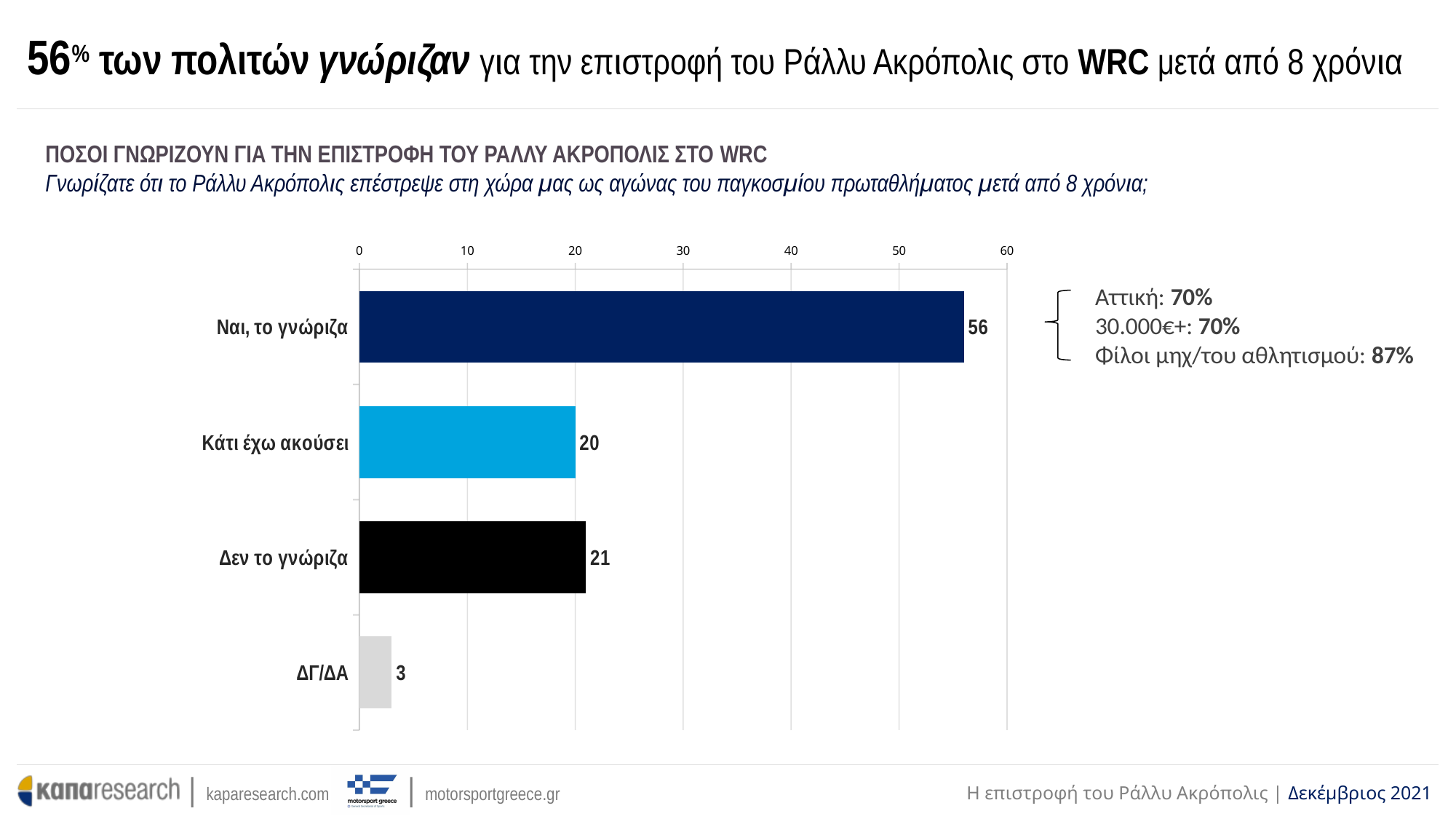
Is the value for "Ναι, το γνώριζα" greater or less than 50? greater What is the value for "ΔΓ/ΔΑ"? 3 What is the value shown for "Αττική" in the annotation next to the chart? 70% Which category has the lowest value? ΔΓ/ΔΑ What is the value for "Δεν το γνώριζα"? 21 How many categories are shown in the chart? 4 What kind of chart is shown on the slide? bar chart What is the difference between the values for "Ναι, το γνώριζα" and "Δεν το γνώριζα"? 35 Which category has the highest value? Ναι, το γνώριζα What is the value for "Ναι, το γνώριζα"? 56 What is the value for "Κάτι έχω ακούσει"? 20 Which is larger, the value for "Ναι, το γνώριζα" or the value for "Κάτι έχω ακούσει"? Ναι, το γνώριζα